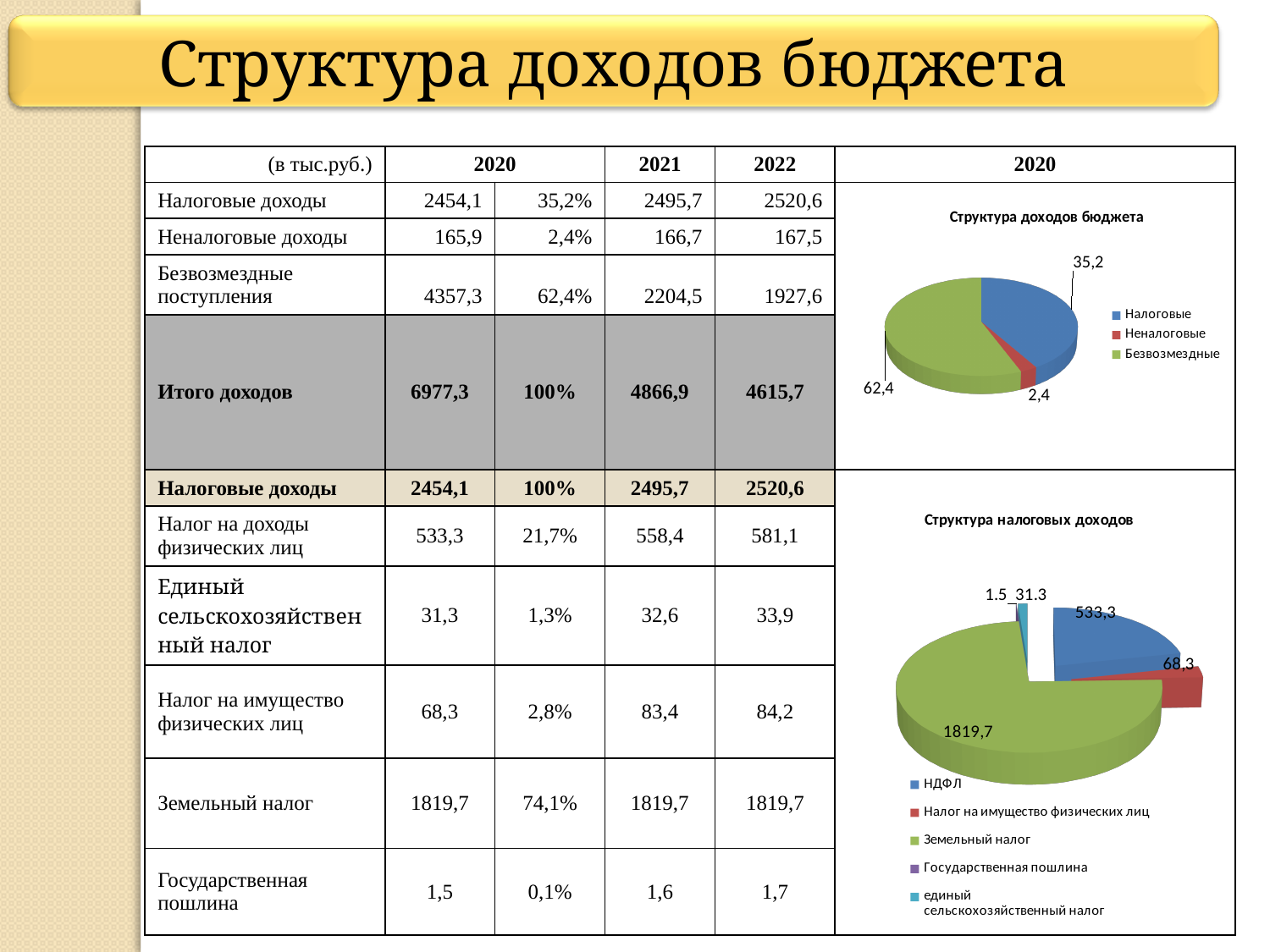
In the chart titled "Структура доходов бюджета", which category has the smallest slice? Неналоговые What type of chart is the chart titled "Структура доходов бюджета"? pie chart In the chart titled "Структура налоговых доходов", what is the value shown for Земельный налог? 1819,7 In the chart titled "Структура налоговых доходов", what is the value shown for Налог на имущество физических лиц? 68,3 How many categories does the legend of the chart titled "Структура налоговых доходов" list? 5 How many entries does the legend of the chart titled "Структура доходов бюджета" list? 3 In the chart titled "Структура налоговых доходов", what is the difference between the values for Земельный налог and НДФЛ? 1286,4 In the chart titled "Структура доходов бюджета", what is the value shown for Налоговые? 35,2 In the chart titled "Структура доходов бюджета", what is the value shown for Неналоговые? 2,4 In the chart titled "Структура налоговых доходов", which category has the smallest slice? Государственная пошлина In the chart titled "Структура налоговых доходов", what is the value shown for НДФЛ? 533,3 In the chart titled "Структура доходов бюджета", which category has the largest slice? Безвозмездные